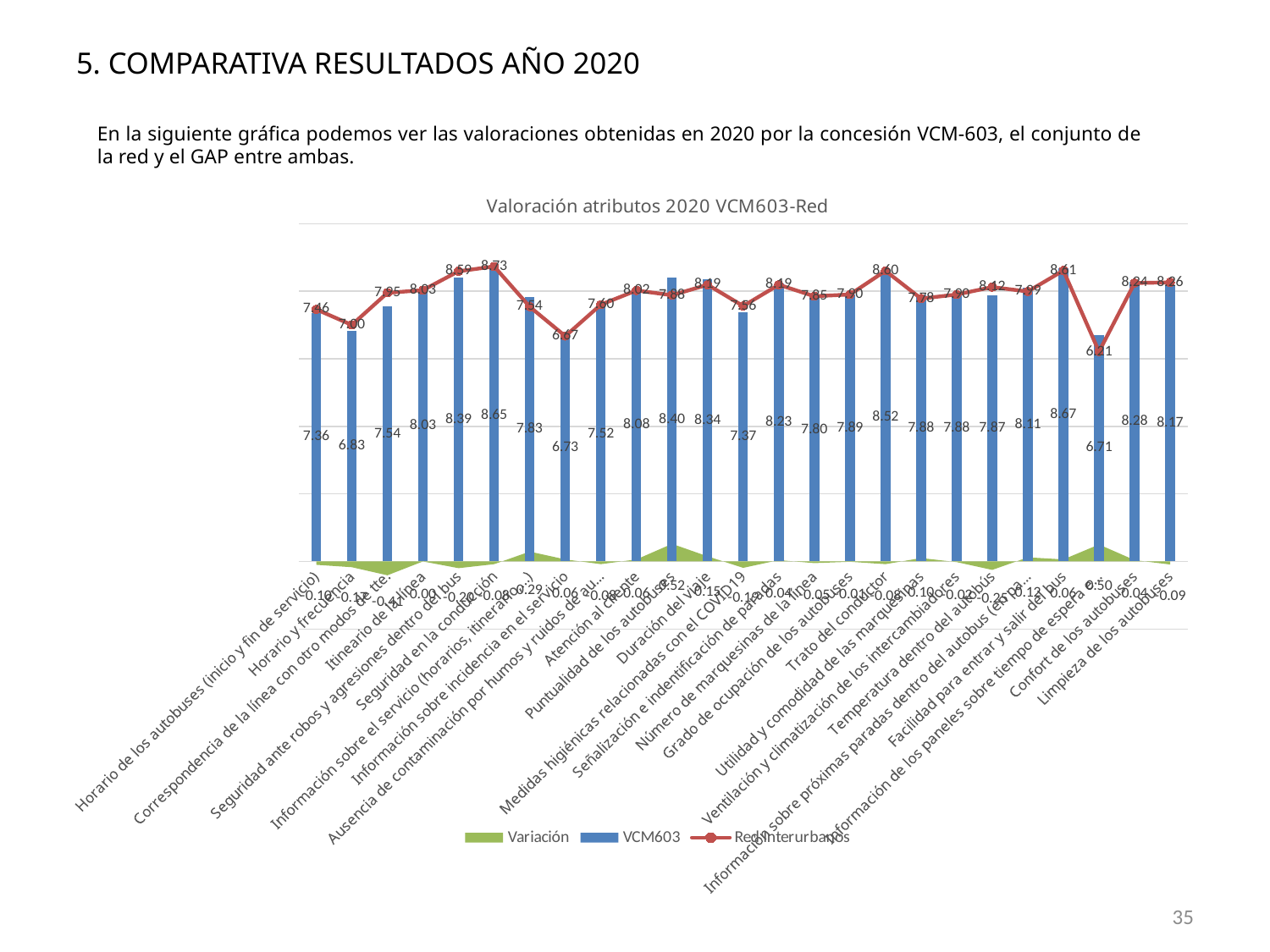
What is the Red Interurbanos value for 'Trato del conductor'? 8,60 How many attribute categories are shown on the x axis? 25 What is the difference between the VCM603 value (6,71) and the Red Interurbanos value (6,21) for 'Información de los paneles sobre tiempo de espera'? 0,50 For 'Horario y frecuencia', which is larger: the VCM603 value or the Red Interurbanos value? Red Interurbanos Which category has the lowest Red Interurbanos value? Información de los paneles sobre tiempo de espera Which category has the highest VCM603 value? Facilidad para entrar y salir del bus What is the VCM603 value for 'Limpieza de los autobuses'? 8,17 How many series does the chart legend list? 3 What is the VCM603 value for 'Seguridad en la conducción'? 8,65 What is the title of the chart? Valoración atributos 2020 VCM603-Red What kind of chart is used to plot the VCM603 series? Bar chart Which category has the highest Red Interurbanos value? Seguridad en la conducción